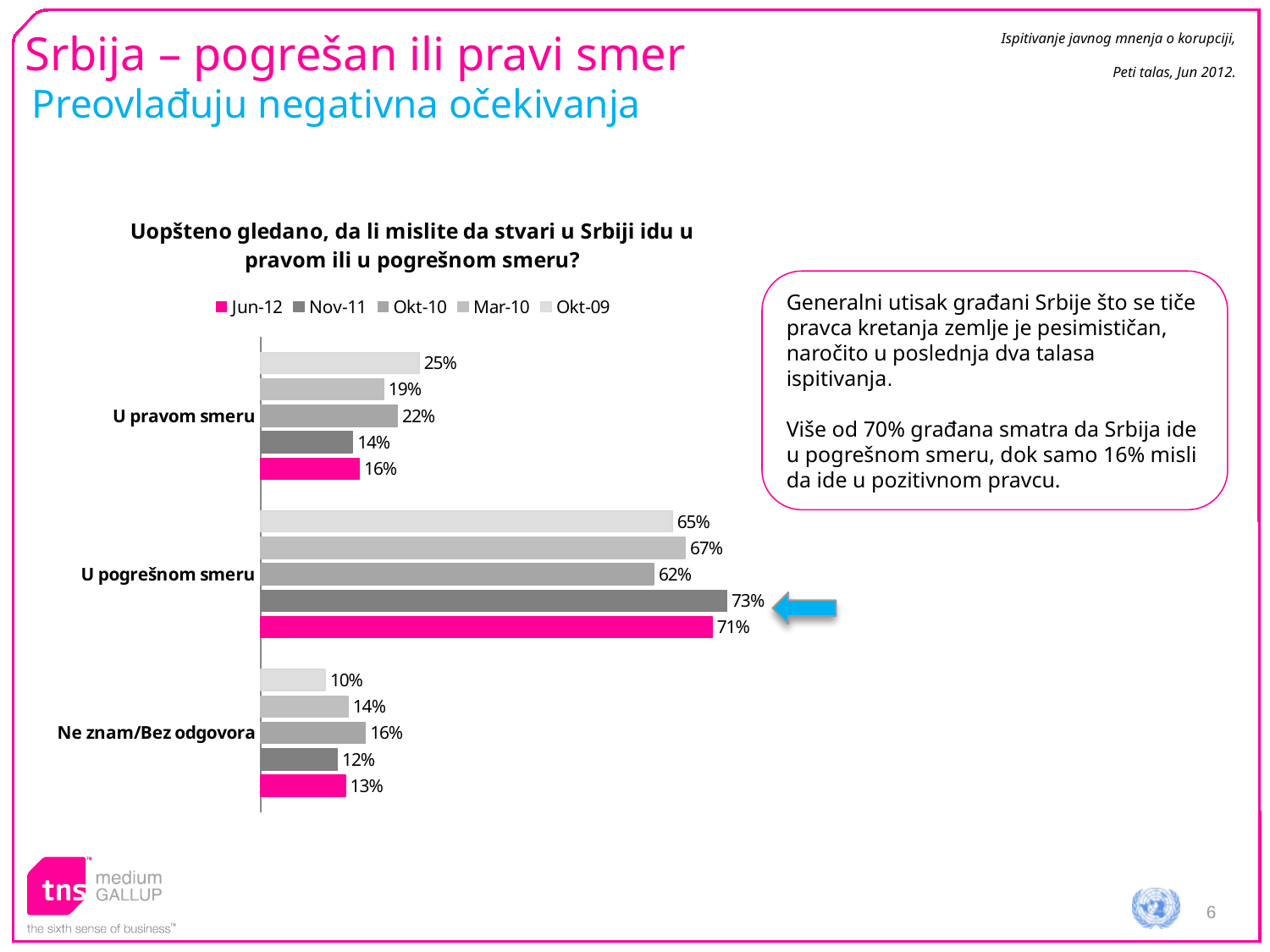
What is the Nov-11 value for "U pogrešnom smeru"? 73% How many survey waves does the legend list? 5 Which survey wave is shown in magenta on the chart? Jun-12 Which survey wave has the lowest value for "U pravom smeru"? Nov-11 Which survey wave has the highest value for "U pogrešnom smeru"? Nov-11 What percentage of respondents answered "U pravom smeru" in the Jun-12 wave? 16% How many response categories are shown on the chart? 3 For "U pravom smeru", which is larger: the Okt-09 value or the Okt-10 value? Okt-09 What is the Okt-09 value for "Ne znam/Bez odgovora"? 10% What is the difference between the Nov-11 and Jun-12 values for "U pogrešnom smeru"? 2% What type of chart is shown on the slide? Bar chart What is the difference between the Okt-09 and Jun-12 values for "U pravom smeru"? 9%